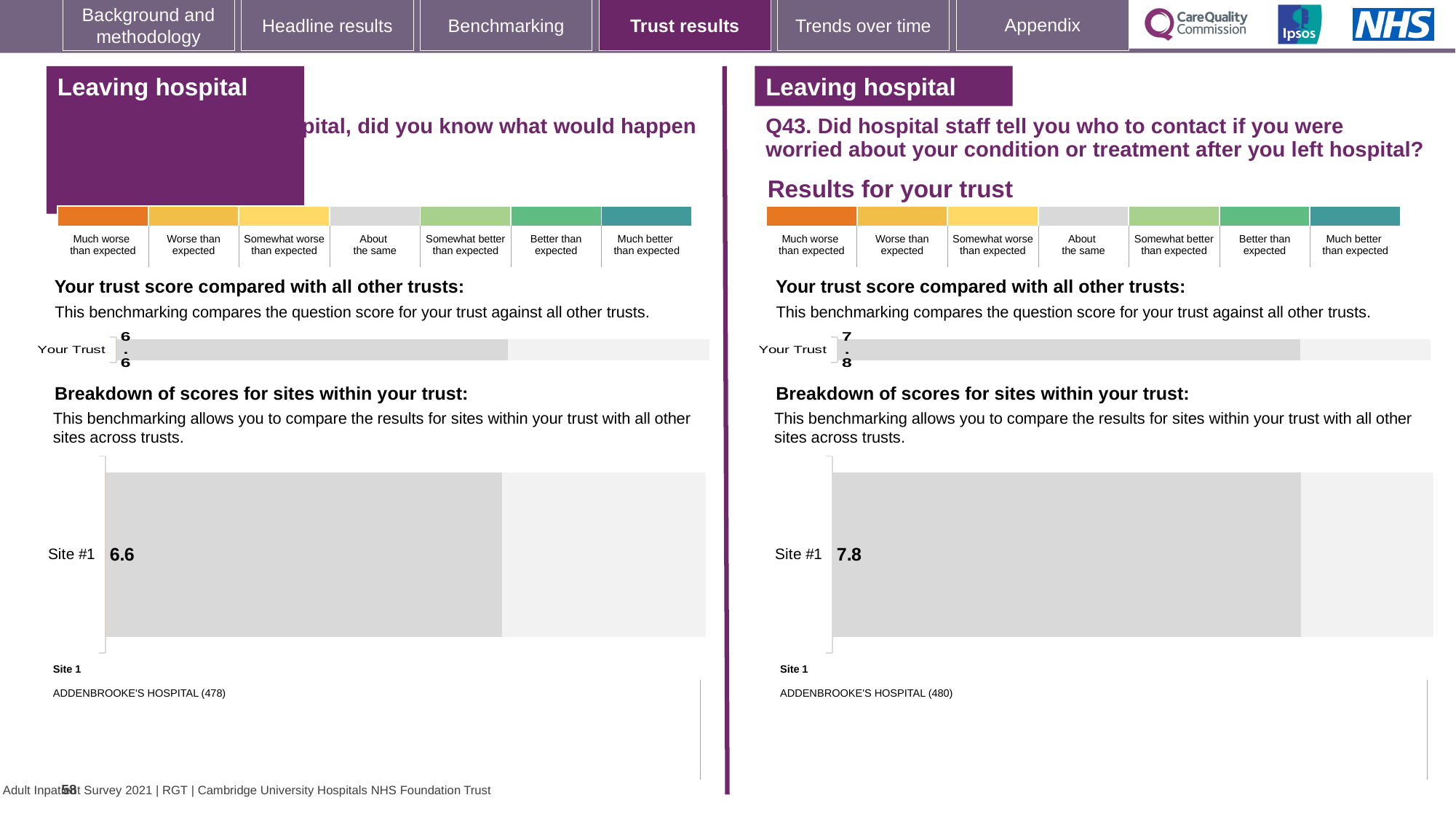
How many sites are shown in the breakdown of scores chart on the right half of the slide (Q43)? 1 What type of chart is used to show the Site #1 score on the right half of the slide (Q43)? Bar chart On the left half of the slide, what is the score shown for Site #1? 6.6 Which is larger: the Site #1 score on the left half of the slide or the Site #1 score on the right half (Q43)? Site #1 on the right half (Q43) On the right half of the slide (Q43), is the Your Trust score equal to the Site #1 score? Yes What is the difference between the Your Trust score on the right half (Q43) and the Your Trust score on the left half of the slide? 1.2 On the right half of the slide (Q43), what is the score shown for Your Trust? 7.8 On the left half of the slide, what is the score shown for Your Trust? 6.6 On the left half of the slide, which site is listed as Site 1? ADDENBROOKE'S HOSPITAL (478) On the right half of the slide (Q43), which site is listed as Site 1? ADDENBROOKE'S HOSPITAL (480) On the right half of the slide (Q43), what is the score shown for Site #1? 7.8